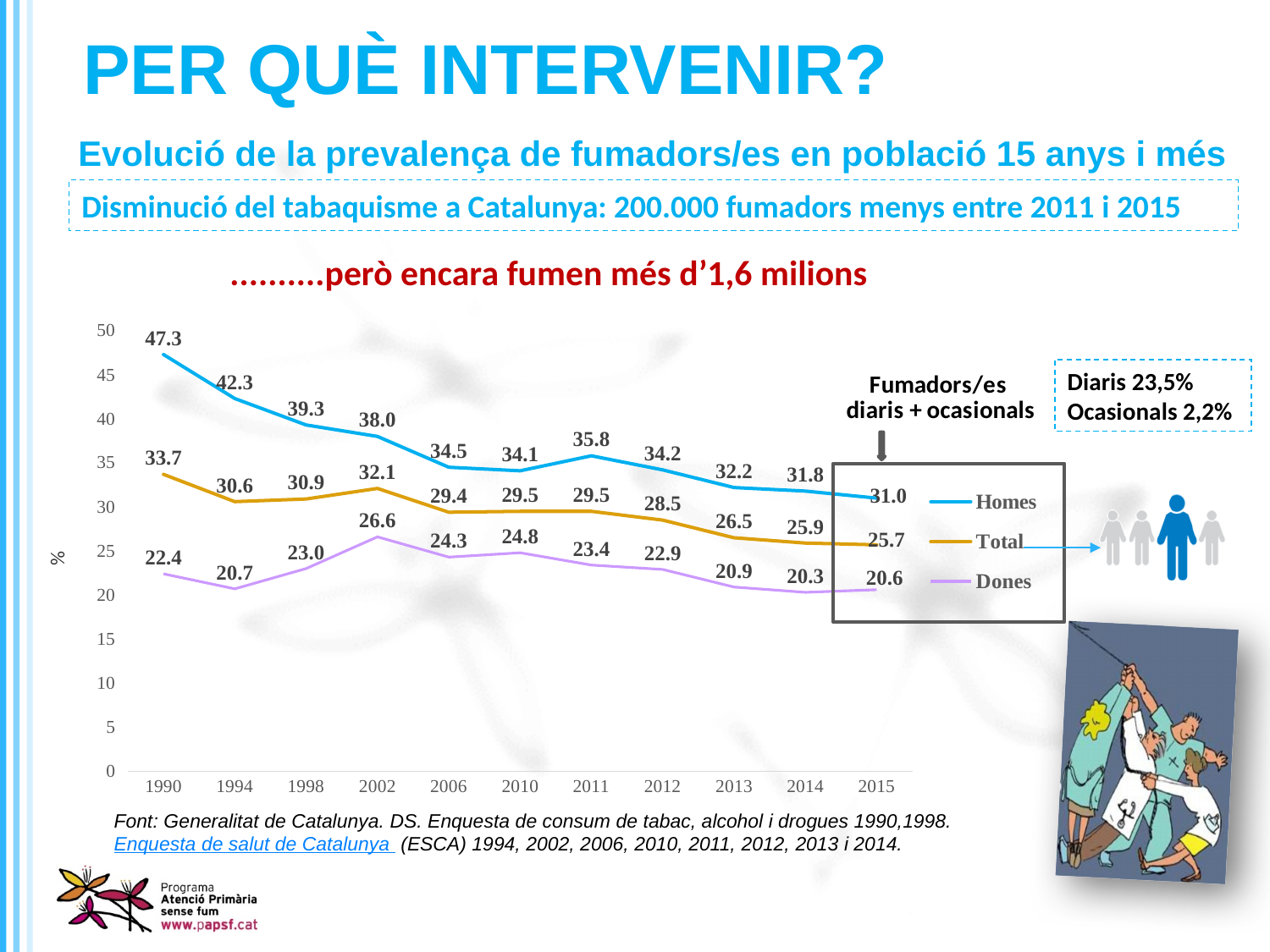
How many series does the chart legend list? 3 Which is larger, the Total value in 1990 or the Total value in 2002? 1990 What is the value for Dones in 2002? 26.6 In which year is the Homes series at its highest? 1990 What is the difference between the Homes value and the Dones value in 2015? 10.4 What is the value for Total in 2015? 25.7 How many years are plotted along the x axis of the chart? 11 Does the Homes series generally rise or fall from 1990 to 2015? fall In which year is the Dones series at its lowest? 2014 What is the value for Homes in 1990? 47.3 Which series is drawn in purple in the chart? Dones What type of chart is shown on the slide? line chart